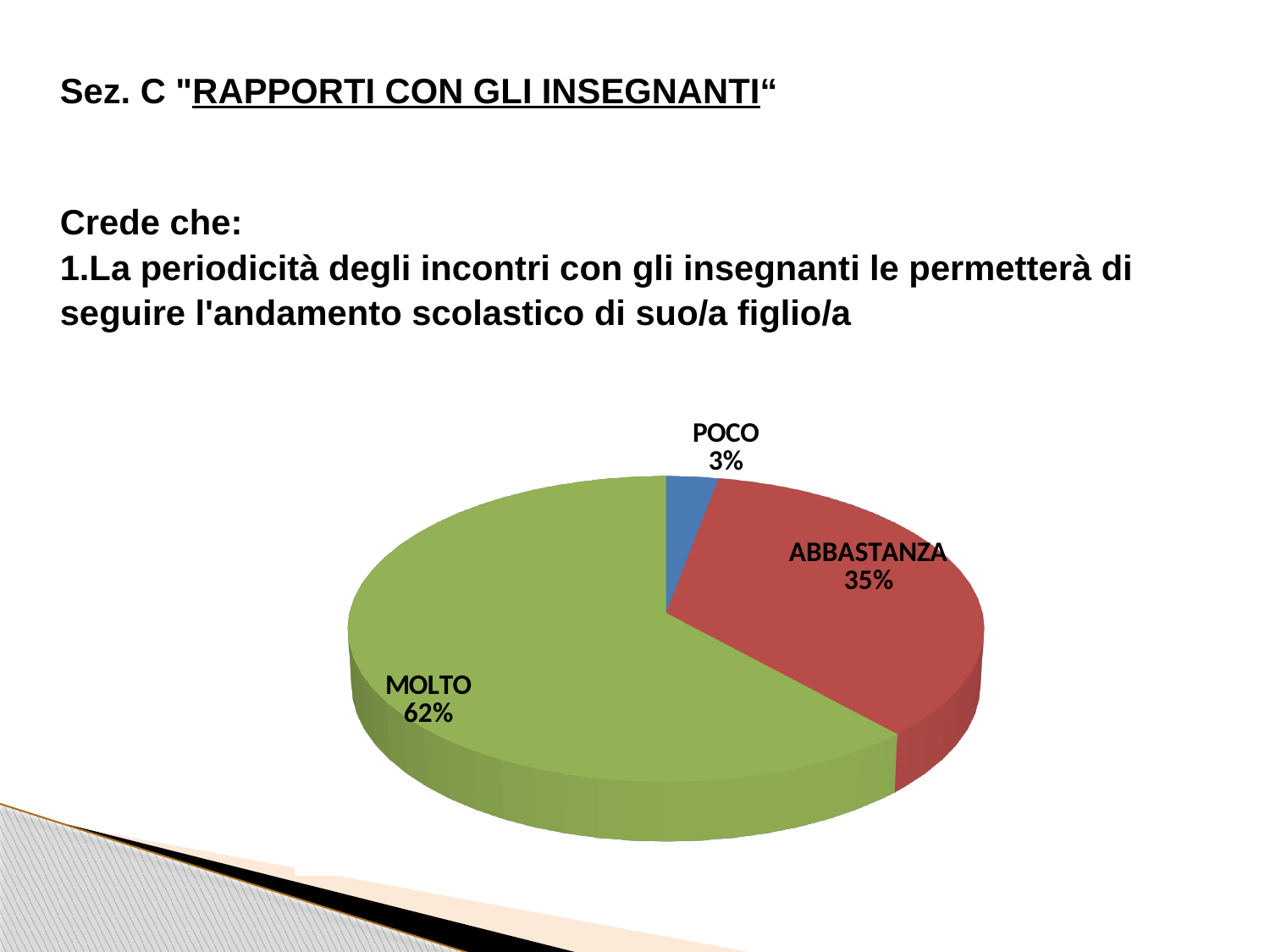
Which category has the largest share of the pie? MOLTO Which category has the smallest share of the pie? POCO How many slices does the pie chart have? 3 What is the difference in percentage points between ABBASTANZA and POCO? 32 What colour is the ABBASTANZA slice? red What kind of chart is shown on the slide? pie chart What percentage is shown for ABBASTANZA? 35% What is the difference in percentage points between MOLTO and ABBASTANZA? 27 What percentage is shown for POCO? 3% What percentage is shown for MOLTO? 62% Which is larger, the share for ABBASTANZA or the share for POCO? ABBASTANZA What colour is the MOLTO slice? green